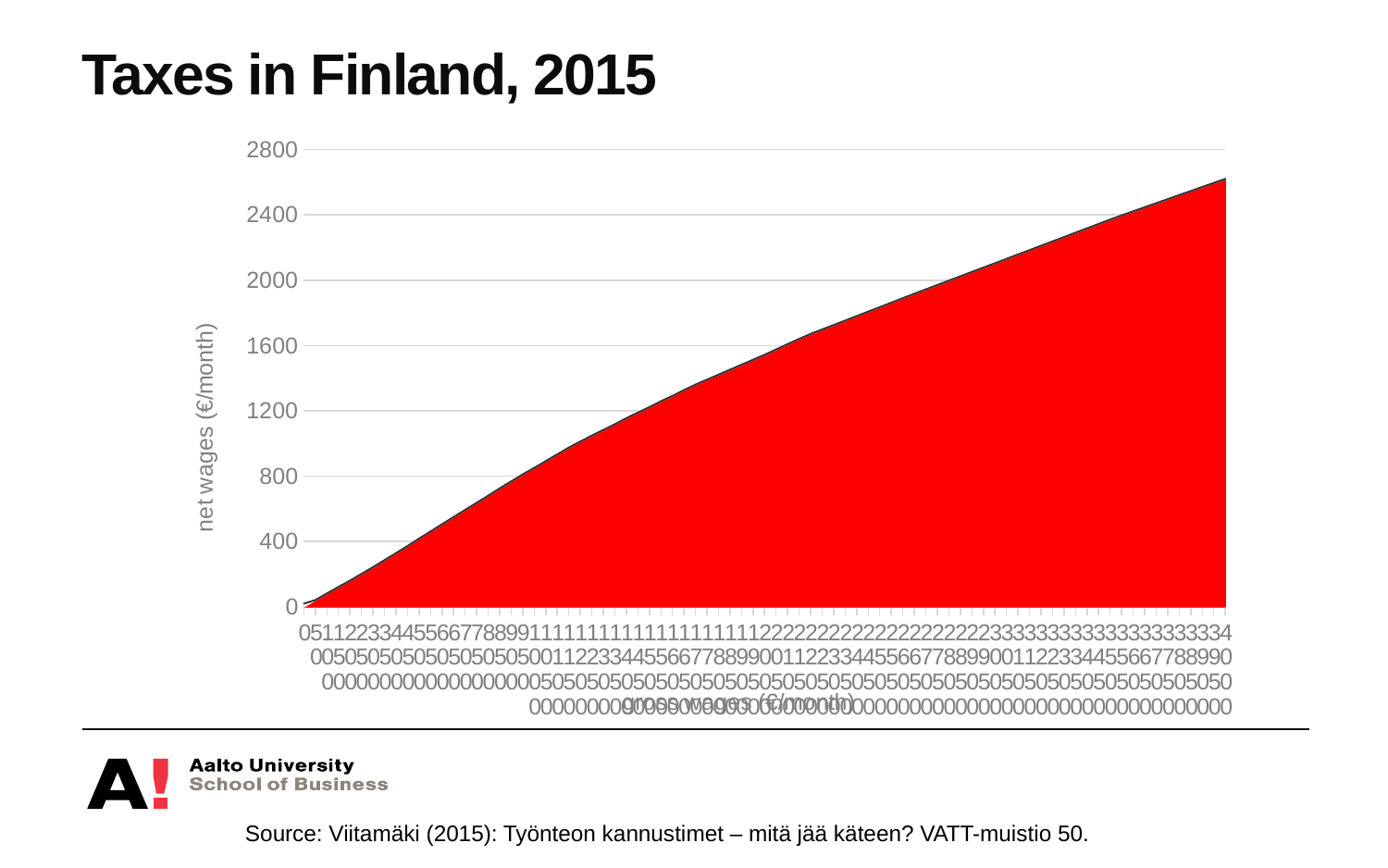
What is the label of the vertical axis? net wages (€/month) Is the highest net wage value plotted on the chart greater or less than 2400? greater What kind of chart is shown on the slide? area chart Is the highest net wage value plotted on the chart greater or less than 2800? less What is the lowest tick value shown on the vertical axis? 0 Is the net wage value at the left end of the chart greater or less than 400? less What is the title of the slide containing the chart? Taxes in Finland, 2015 Do the net wages rise or fall as gross wages increase along the x axis? rise What is the highest tick value shown on the vertical axis? 2800